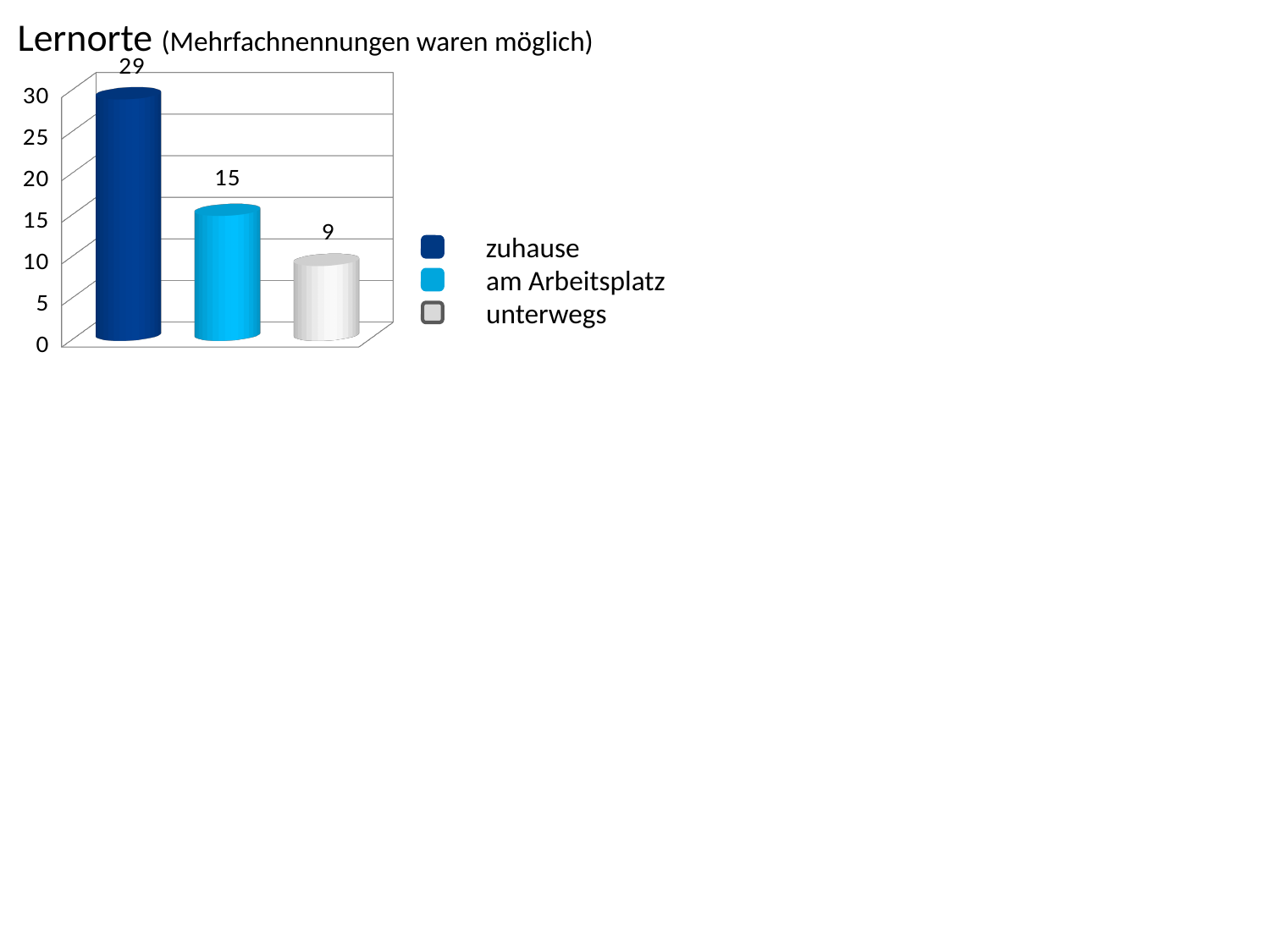
What is the value for zuhause? 29 Which category has the lowest value? unterwegs What is the value for am Arbeitsplatz? 15 What is the difference between the values for am Arbeitsplatz and unterwegs? 6 What is the title of the chart? Lernorte (Mehrfachnennungen waren möglich) Which is larger, the value for am Arbeitsplatz or the value for unterwegs? am Arbeitsplatz Which category has the highest value? zuhause What is the value for unterwegs? 9 What is the difference between the values for zuhause and am Arbeitsplatz? 14 Is the value for zuhause greater or less than 25? greater What kind of chart is shown on the slide? bar chart How many categories are shown in the chart? 3